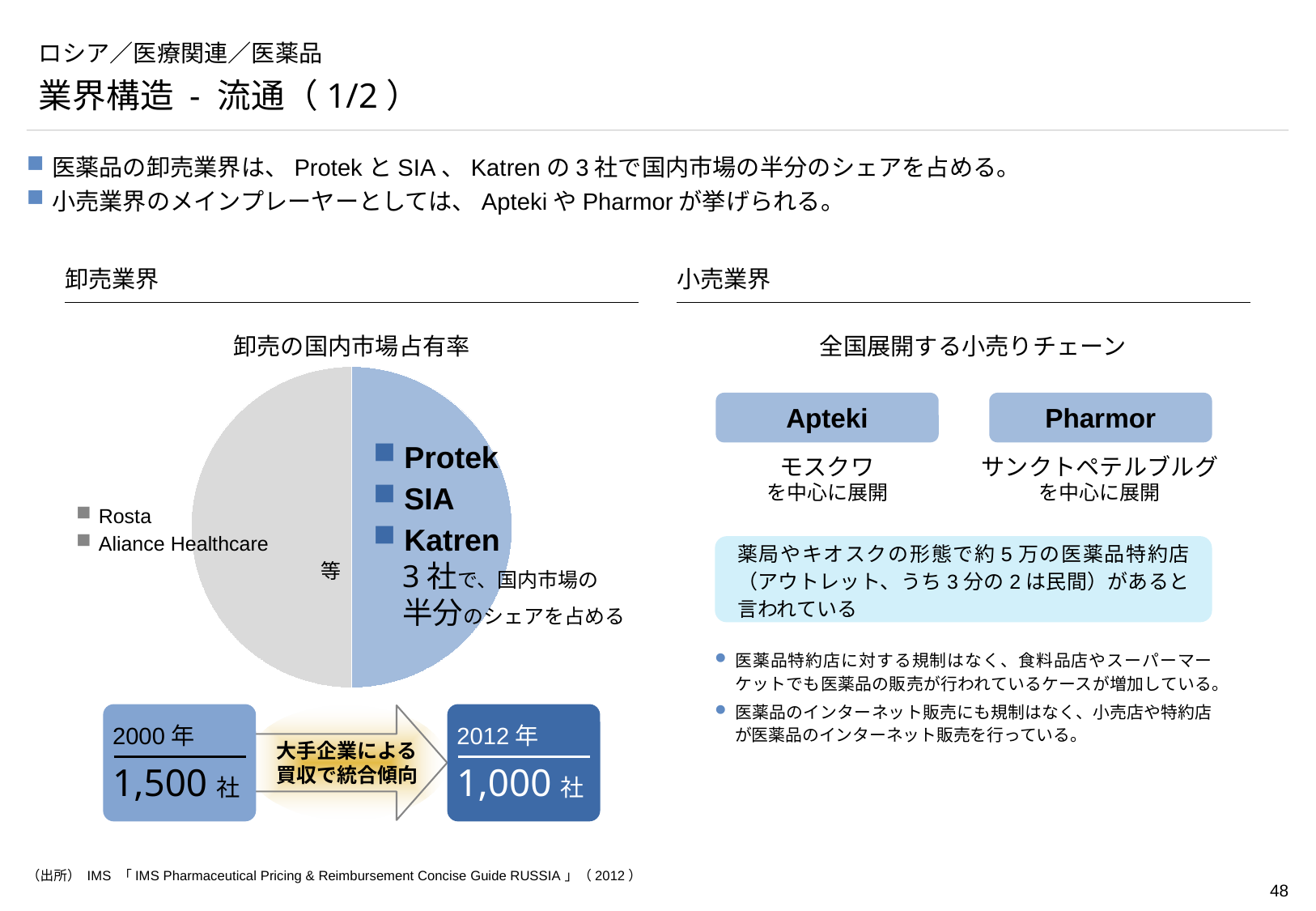
In the pie chart 卸売の国内市場占有率, which companies are listed in the legend for the gray slice? Rosta, Aliance Healthcare In the pie chart 卸売の国内市場占有率, what share of the domestic market do Protek, SIA and Katren hold together? 半分 In the pie chart 卸売の国内市場占有率, which three companies are named in the blue slice? Protek, SIA, Katren How many slices does the pie chart 卸売の国内市場占有率 have? 2 What kind of chart is shown under 卸売の国内市場占有率? pie chart What is the title of the pie chart on the left side of the slide? 卸売の国内市場占有率 In the pie chart 卸売の国内市場占有率, how many companies are named in the blue slice? 3